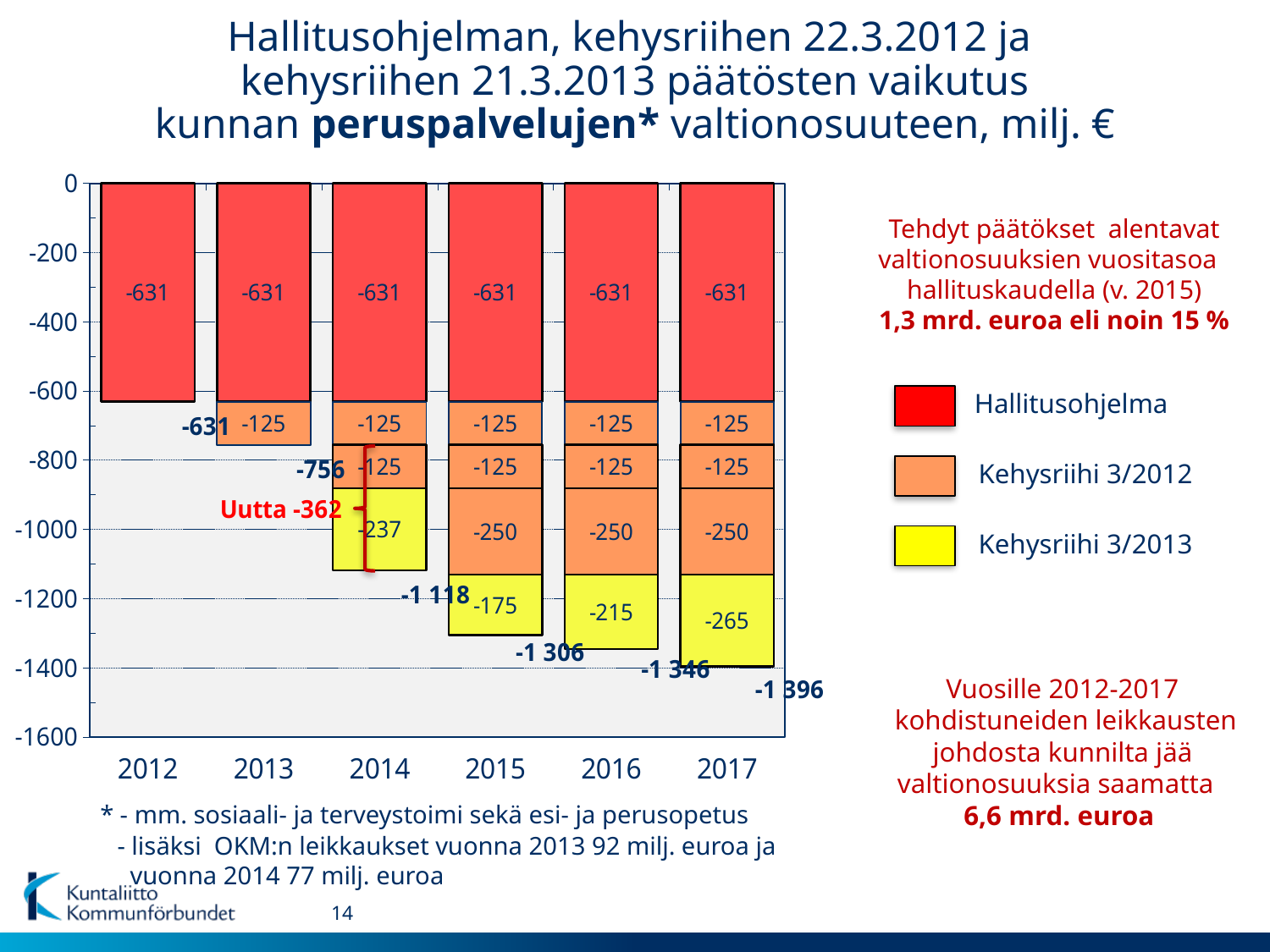
What is the value of the Hallitusohjelma segment for 2015? -631 Do the total cuts grow or shrink in magnitude from 2012 to 2017? grow How many years are shown on the x axis of the chart? 6 What is the difference between the Kehysriihi 3/2013 segments for 2017 and 2015? 90 What is the value of the Kehysriihi 3/2013 segment for 2014? -237 What type of chart is shown on the slide? stacked bar chart What is the total of the stacked bar for 2014? -1 118 Which year has the smallest total cut (the shortest stacked bar)? 2012 How many series does the chart's legend list? 3 What is the value of the Kehysriihi 3/2013 segment for 2017? -265 Which year has the largest total cut (the longest stacked bar)? 2017 What is the total of the stacked bar for 2016? -1 346